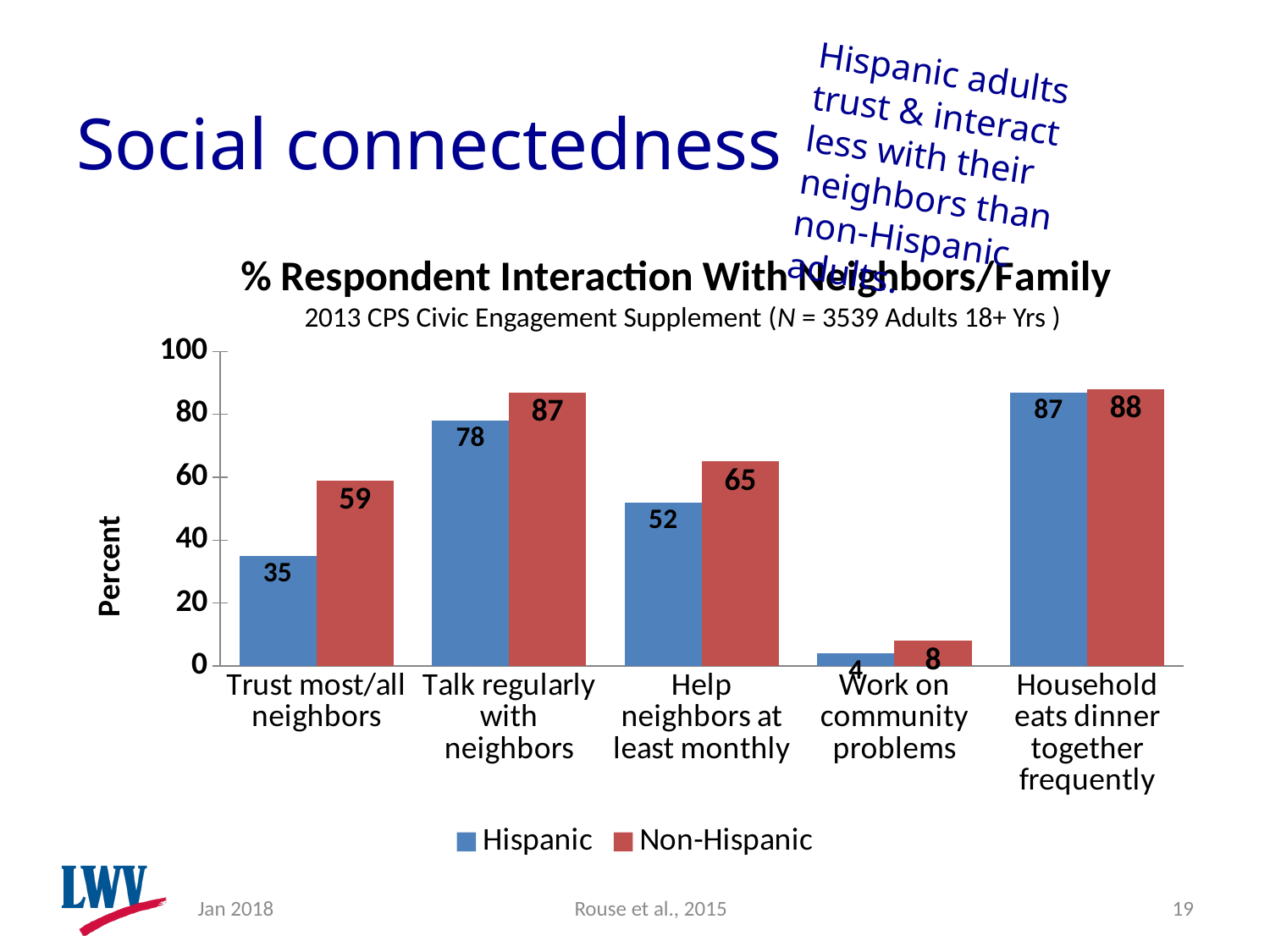
Which category has the lowest Hispanic value? Work on community problems How many series does the legend list? 2 Which category has the highest Non-Hispanic value? Household eats dinner together frequently What is the difference between the Non-Hispanic and Hispanic values for "Trust most/all neighbors"? 24 What is the difference between the Non-Hispanic and Hispanic values for "Talk regularly with neighbors"? 9 What is the Non-Hispanic value for "Help neighbors at least monthly"? 65 What is the label of the y axis? Percent For "Help neighbors at least monthly", which group has the larger value, Hispanic or Non-Hispanic? Non-Hispanic What is the Hispanic value for "Trust most/all neighbors"? 35 What is the Hispanic value for "Work on community problems"? 4 What kind of chart is shown on the slide? Bar chart How many categories are shown on the x axis? 5